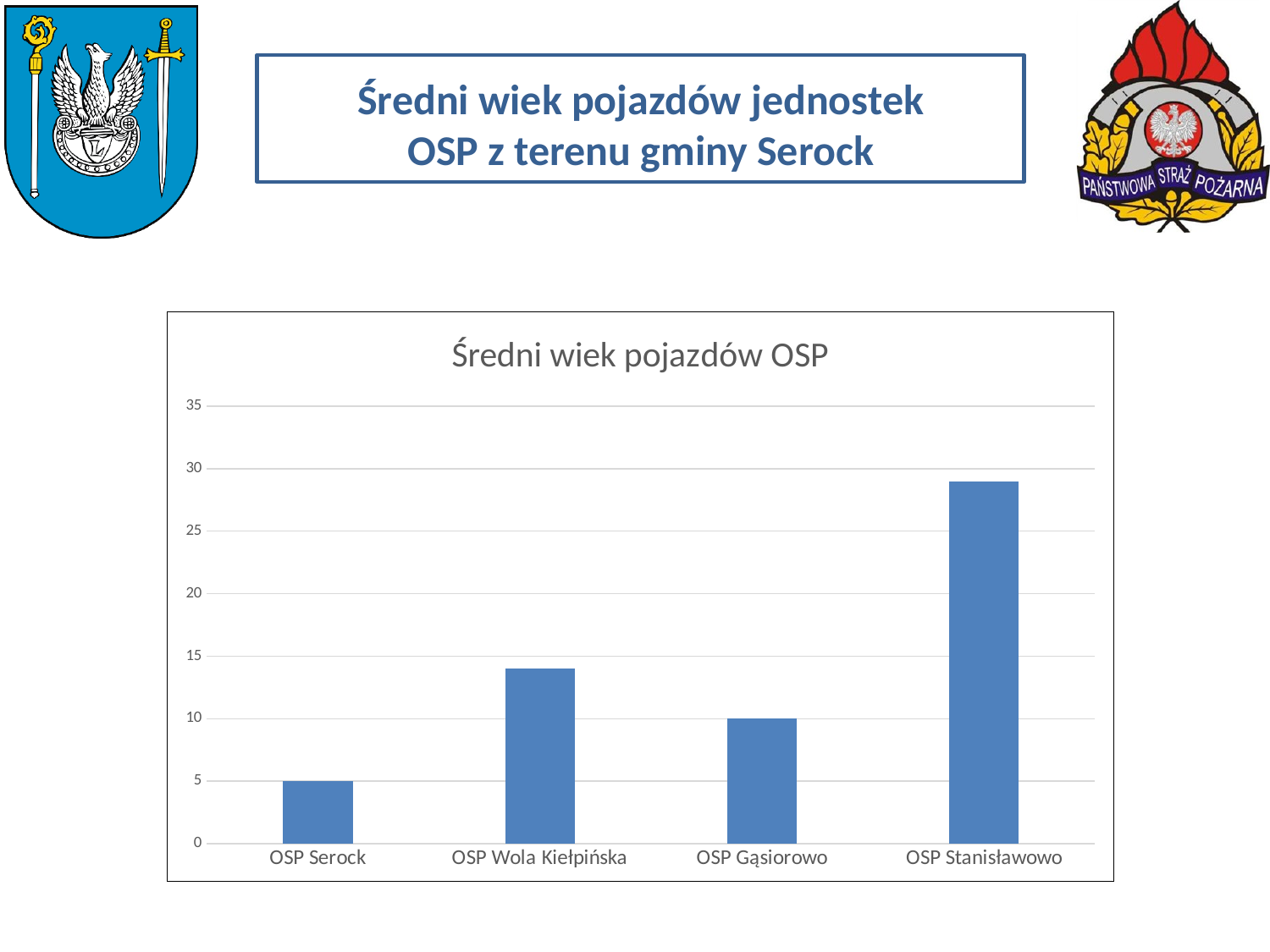
Which OSP unit has the lowest average vehicle age? OSP Serock What is the difference between the values for OSP Gąsiorowo and OSP Serock? 5 Is the value for OSP Wola Kiełpińska greater or less than 15? less What is the average vehicle age for OSP Gąsiorowo? 10 What is the title of the chart? Średni wiek pojazdów OSP Which has a higher average vehicle age, OSP Wola Kiełpińska or OSP Gąsiorowo? OSP Wola Kiełpińska What type of chart is shown on the slide? bar chart Which OSP unit has the highest average vehicle age? OSP Stanisławowo What is the highest value shown on the vertical axis? 35 What is the average vehicle age for OSP Serock? 5 Is the value for OSP Stanisławowo greater or less than 25? greater How many OSP units are shown on the chart? 4